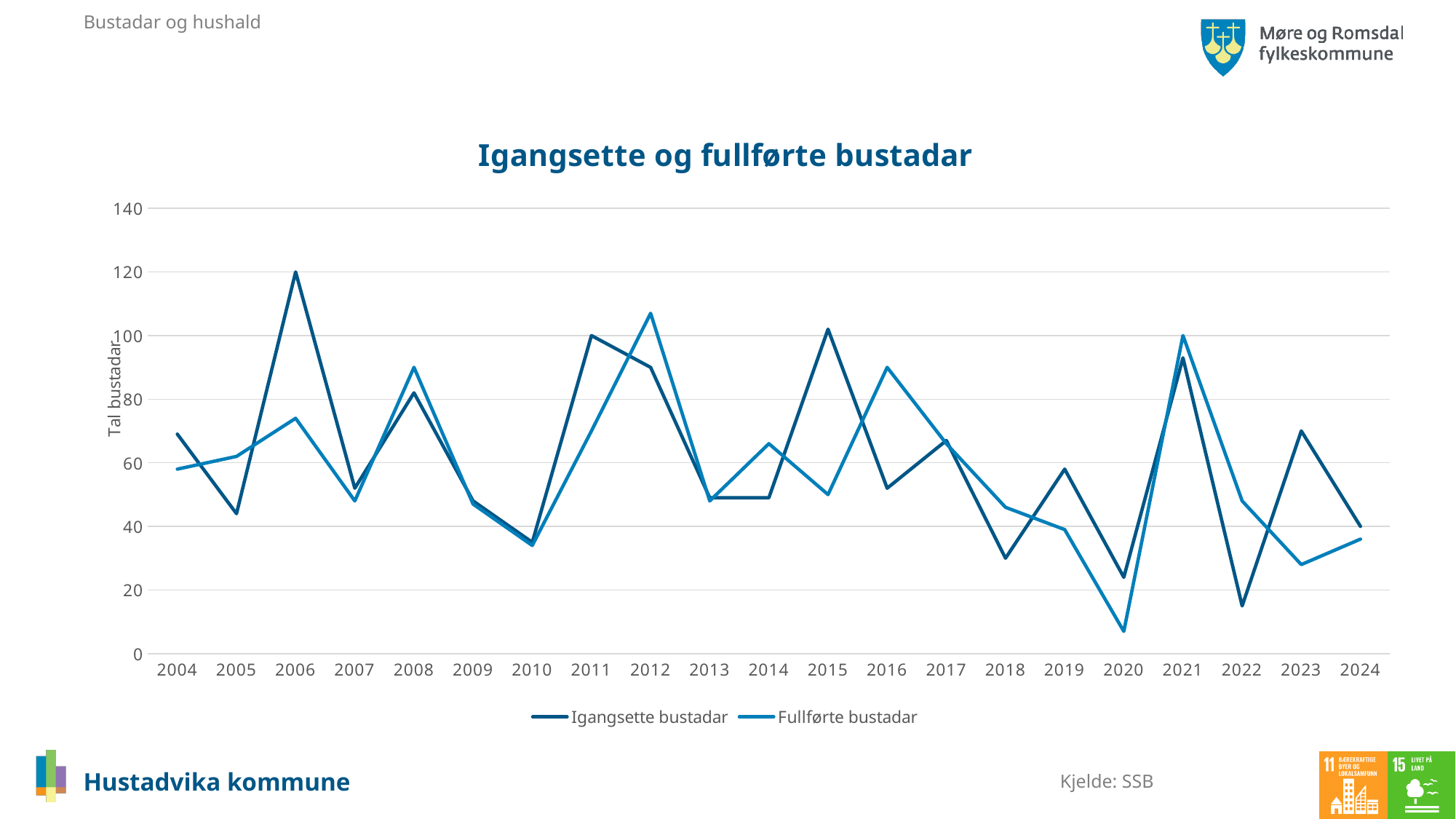
Is the value for Fullførte bustadar in 2012 greater or less than 100? greater Is the value for Igangsette bustadar in 2022 greater or less than 20? less In 2016, which series has the larger value, Igangsette bustadar or Fullførte bustadar? Fullførte bustadar In which year is the value for Fullførte bustadar highest? 2012 In which year is the value for Fullførte bustadar lowest? 2020 In which year is the value for Igangsette bustadar highest? 2006 Is the value for Fullførte bustadar in 2020 greater or less than 20? less What is the title of the chart? Igangsette og fullførte bustadar How many years are shown on the x axis? 21 How many series does the legend list? 2 What kind of chart is shown on the slide? line chart In 2006, which series has the larger value, Igangsette bustadar or Fullførte bustadar? Igangsette bustadar